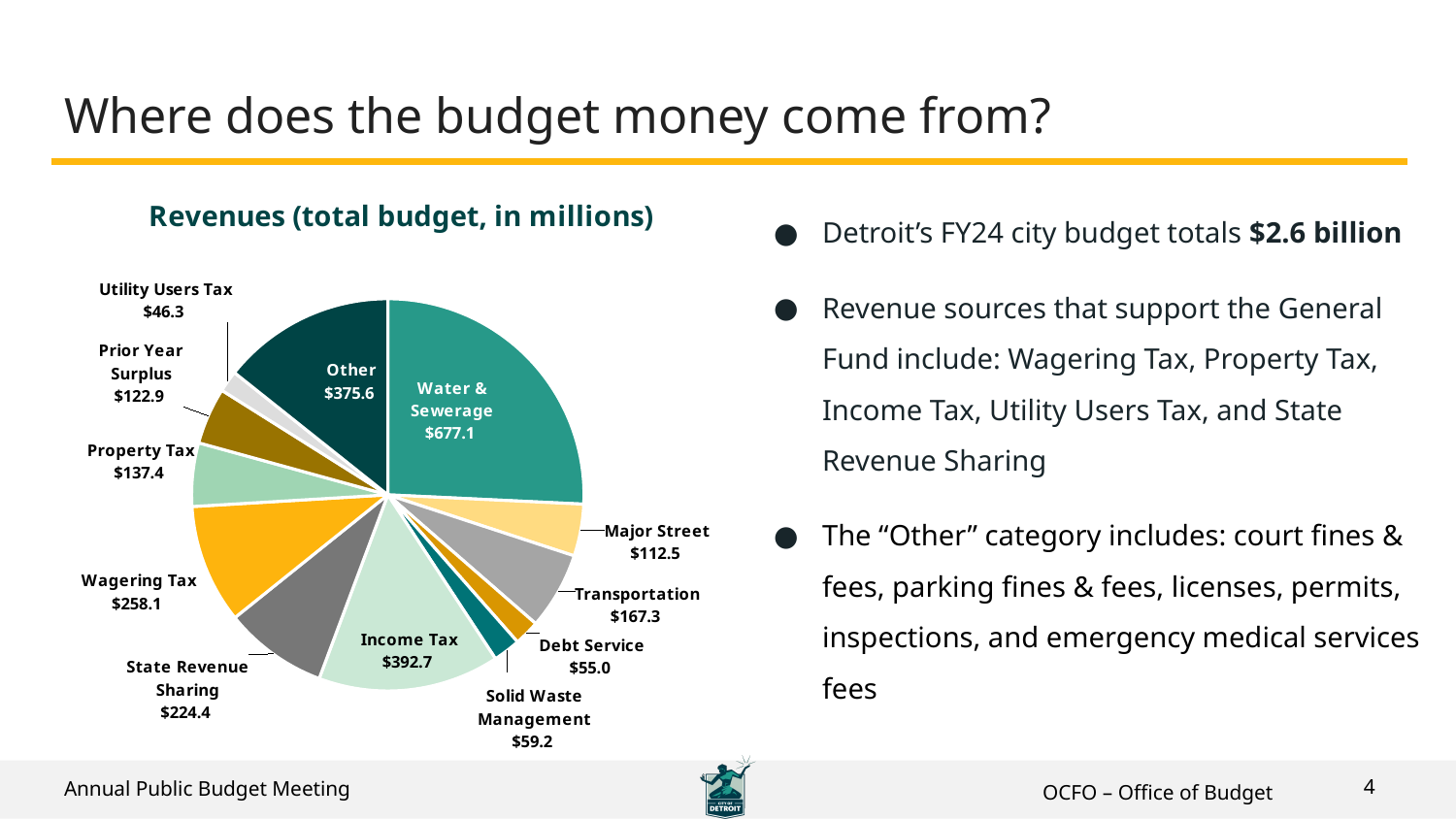
What is the value for State Revenue Sharing? $224.4 How many revenue categories are shown in the pie chart? 12 Which revenue category has the smallest slice? Utility Users Tax What type of chart is shown on the slide? Pie chart What is the value for Water & Sewerage? $677.1 Which revenue category has the largest slice? Water & Sewerage What is the value for Debt Service? $55.0 Which is larger, State Revenue Sharing or Transportation? State Revenue Sharing What is the difference between Water & Sewerage and Other? $301.5 What is the title of the chart? Revenues (total budget, in millions) What is the value for Income Tax? $392.7 What is the difference between Income Tax and Wagering Tax? $134.6